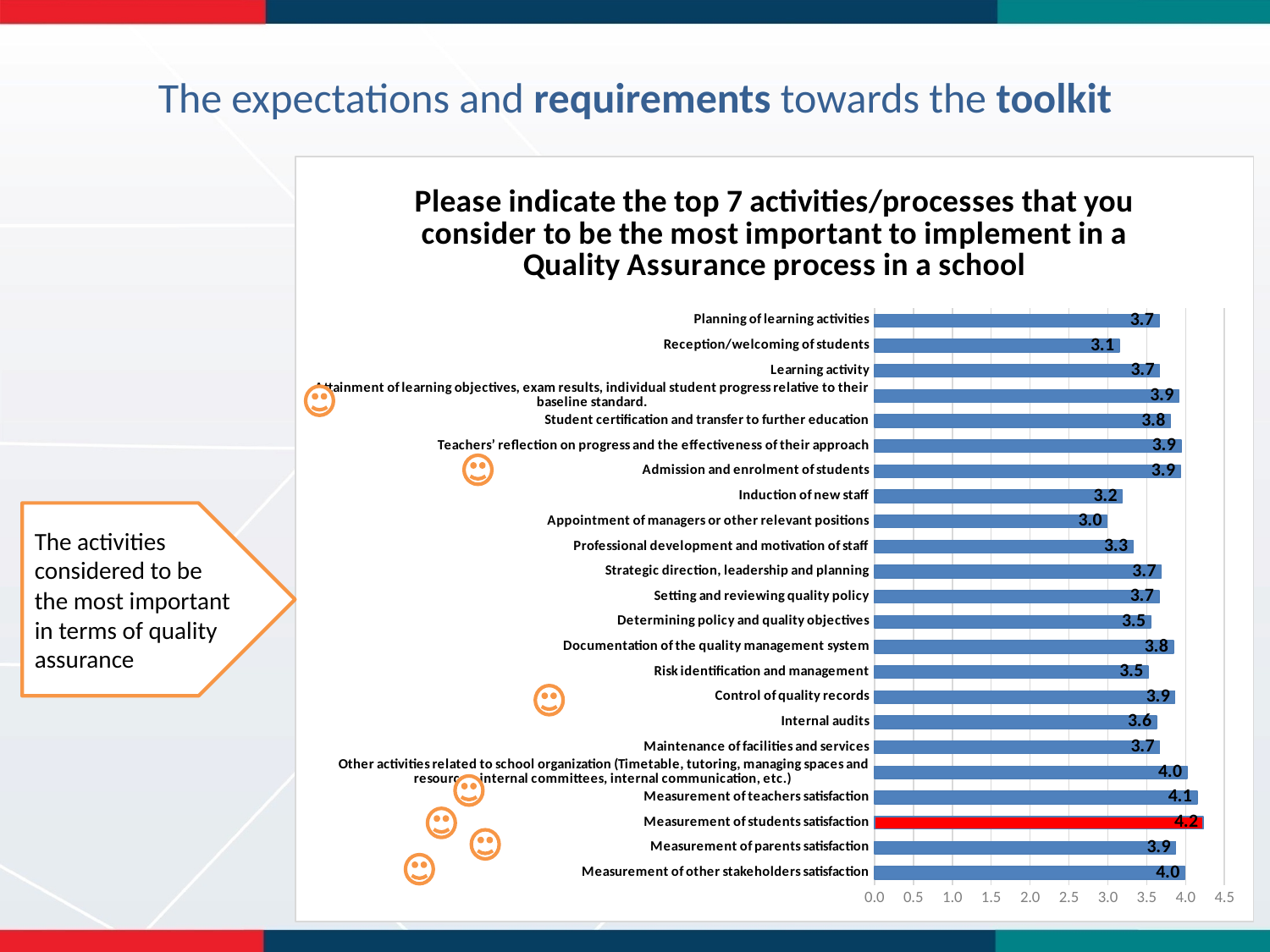
How many activities are plotted in the chart? 23 What is the value for Induction of new staff? 3.2 What is the difference between the values for Measurement of teachers satisfaction and Professional development and motivation of staff? 0.8 What is the value for Internal audits? 3.6 Which bar is coloured red instead of blue? Measurement of students satisfaction Which activity has the highest value? Measurement of students satisfaction Is the value for Measurement of other stakeholders satisfaction greater or less than 3.5? greater What is the value for Reception/welcoming of students? 3.1 Which activity has the lowest value? Appointment of managers or other relevant positions What kind of chart is shown on the slide? bar chart Which has a larger value, Control of quality records or Risk identification and management? Control of quality records What is the value for Measurement of students satisfaction? 4.2